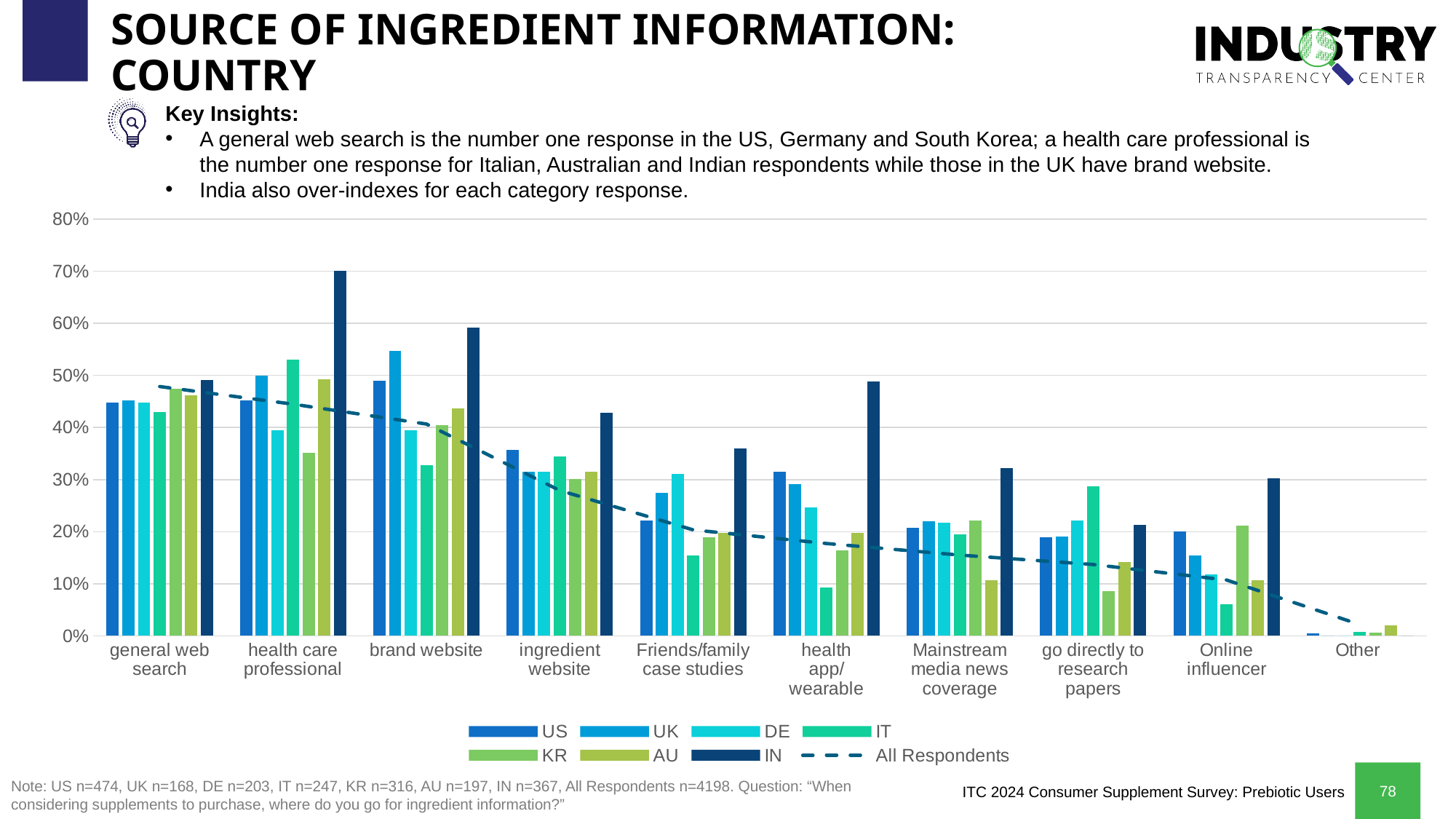
Is the value for KR for health app/wearable greater or less than 10%? greater Which country has the lowest value for health care professional? KR Which country has the highest value for brand website? IN Is the value for IN for health care professional greater or less than 60%? greater For ingredient website, which is larger, the value for IN or the value for US? IN Which country has the highest value for health care professional? IN What kind of chart is shown on the slide? Bar chart with a dashed line Does the All Respondents dashed line rise or fall from left to right across the categories? Fall How many categories are shown along the x axis? 10 Which country has the lowest value for health app/wearable? IT Is the value for IN for health app/wearable greater or less than 40%? greater How many entries does the legend list? 8